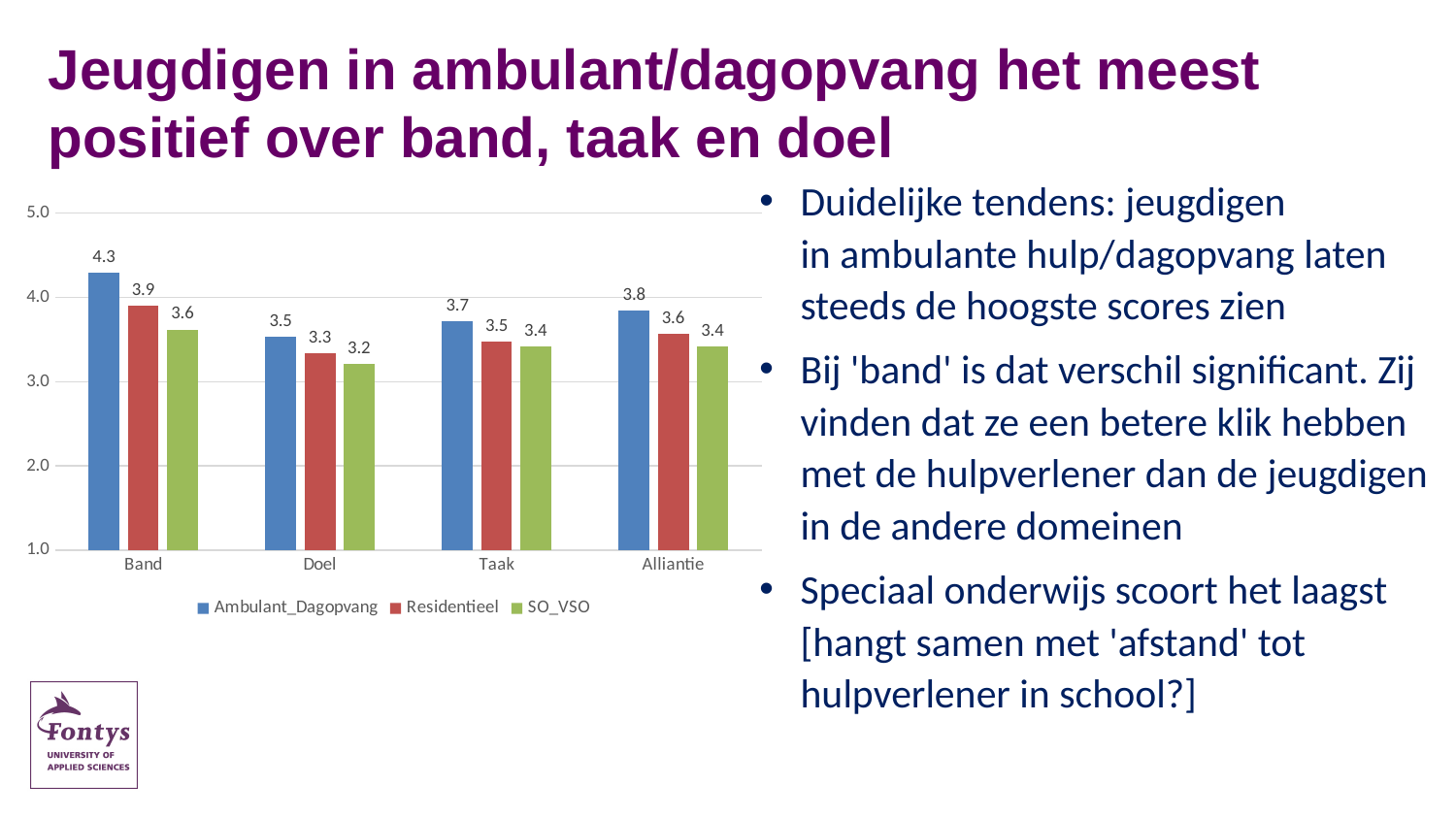
How many categories are shown on the x axis? 4 Is the value for Ambulant_Dagopvang in the Band category greater or less than 4.0? greater What is the difference between the Ambulant_Dagopvang and SO_VSO values in the Band category? 0.7 Which is larger in the Alliantie category: Residentieel or SO_VSO? Residentieel Which series is shown in green in the legend? SO_VSO Which category has the highest value for Ambulant_Dagopvang? Band What is the value for SO_VSO in the Doel category? 3.2 Which category has the lowest value for SO_VSO? Doel What is the value for Residentieel in the Taak category? 3.5 What kind of chart is shown on the slide? Bar chart What is the value for Ambulant_Dagopvang in the Band category? 4.3 How many series does the legend list? 3